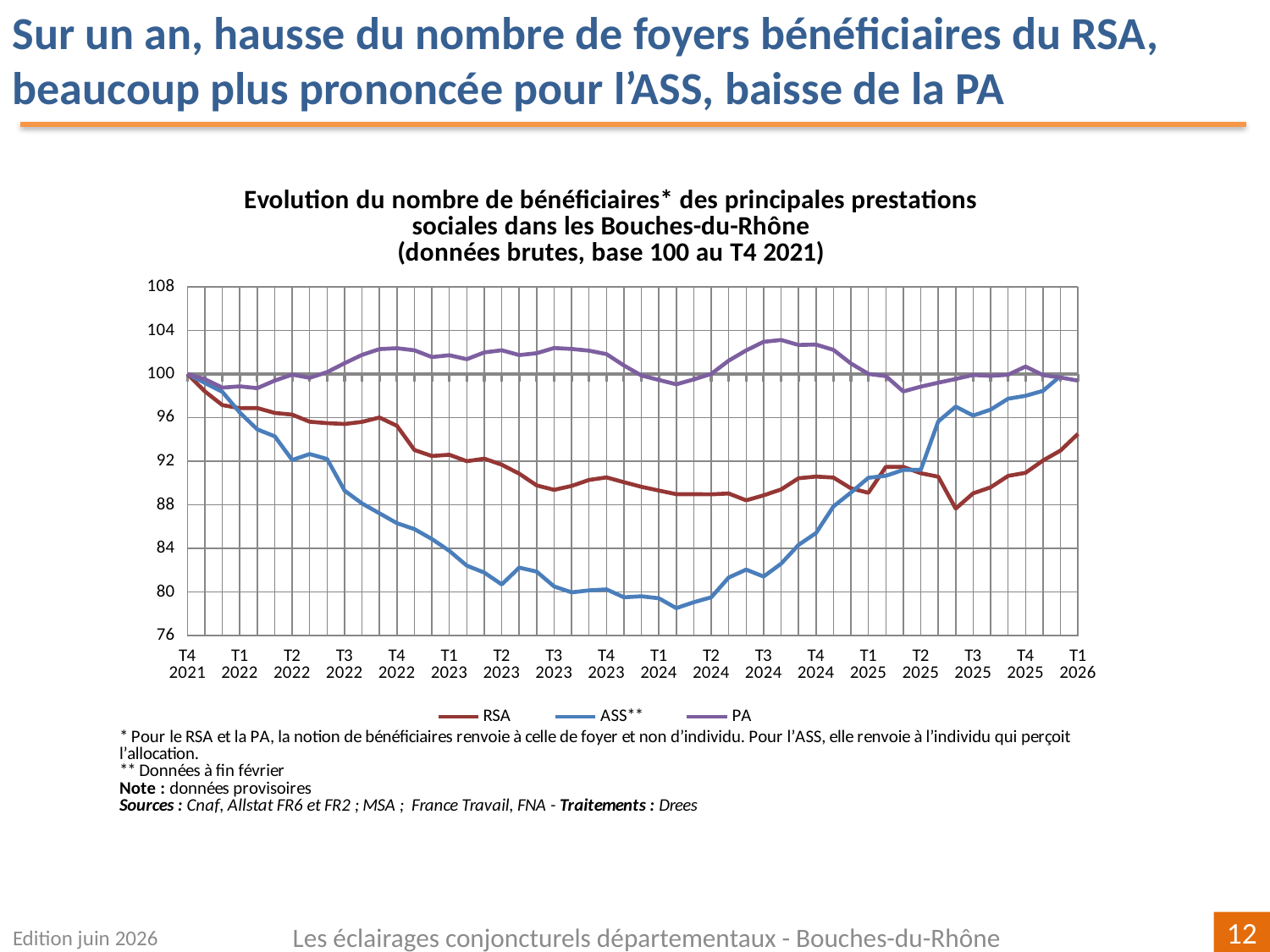
Does the ASS** series rise or fall between T4 2021 and T1 2024? fall What kind of chart is shown on the slide? line chart What is the value of all three series at T4 2021? 100 Which series are listed in the legend? RSA, ASS**, PA Is the value for RSA at T3 2025 greater or less than 92? less Which series has the highest value at T4 2022? PA Is the value for PA at T3 2024 greater or less than 100? greater Is the value for ASS** at T2 2022 greater or less than 96? less How many series does the legend list? 3 Which series has the lowest value at T1 2024? ASS**